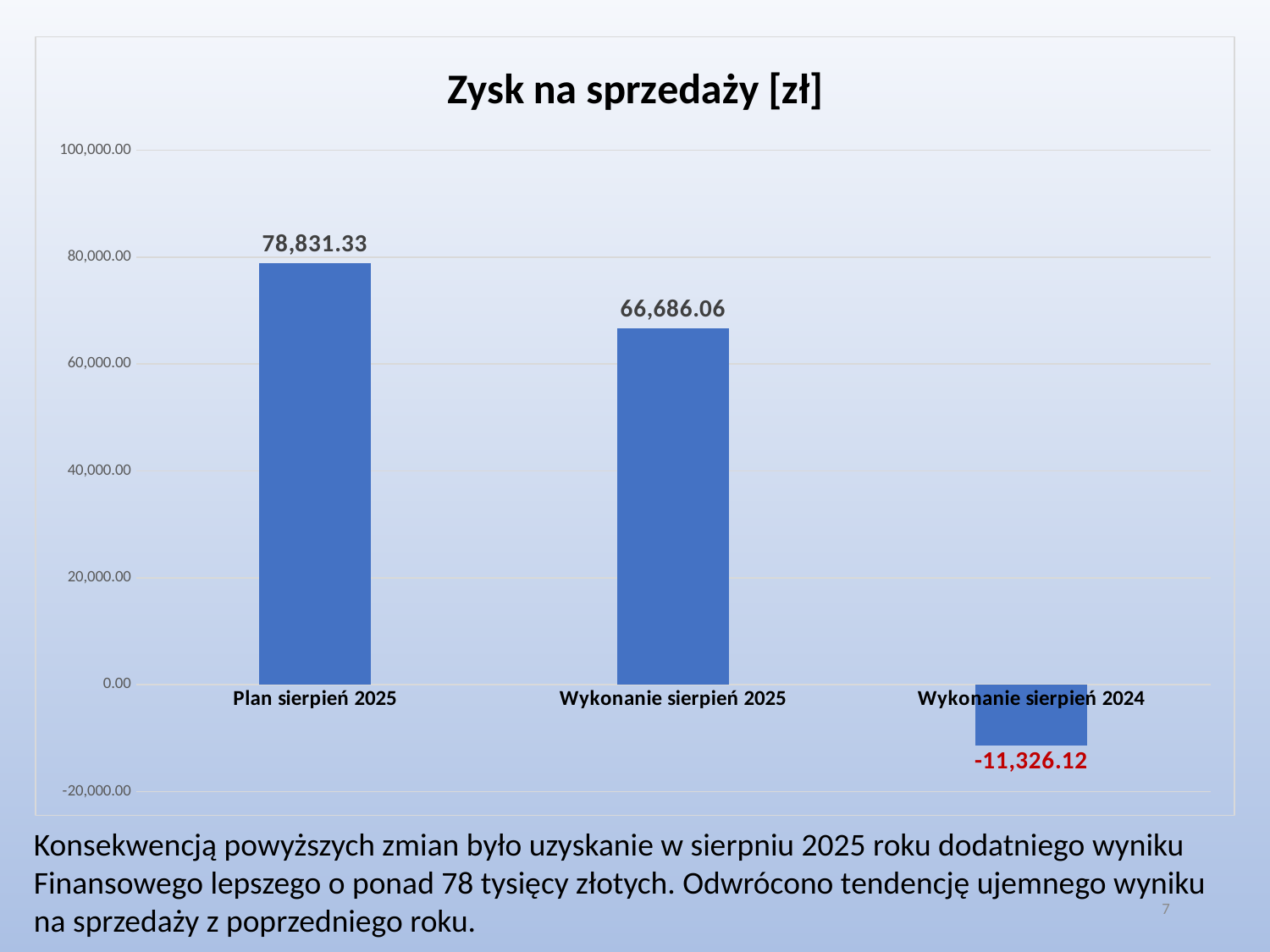
Which category has the highest value? Plan sierpień 2025 What is the value for Plan sierpień 2025? 78,831.33 What is the value for Wykonanie sierpień 2025? 66,686.06 Which is larger, Wykonanie sierpień 2025 or Wykonanie sierpień 2024? Wykonanie sierpień 2025 What is the value for Wykonanie sierpień 2024? -11,326.12 What is the difference between Wykonanie sierpień 2025 and Wykonanie sierpień 2024? 78,012.18 What is the title of the chart? Zysk na sprzedaży [zł] How many categories are shown in the chart? 3 Is the value for Wykonanie sierpień 2025 greater or less than 60,000.00? greater What kind of chart is shown on the slide? bar chart What is the difference between Plan sierpień 2025 and Wykonanie sierpień 2025? 12,145.27 Which category has the lowest value? Wykonanie sierpień 2024